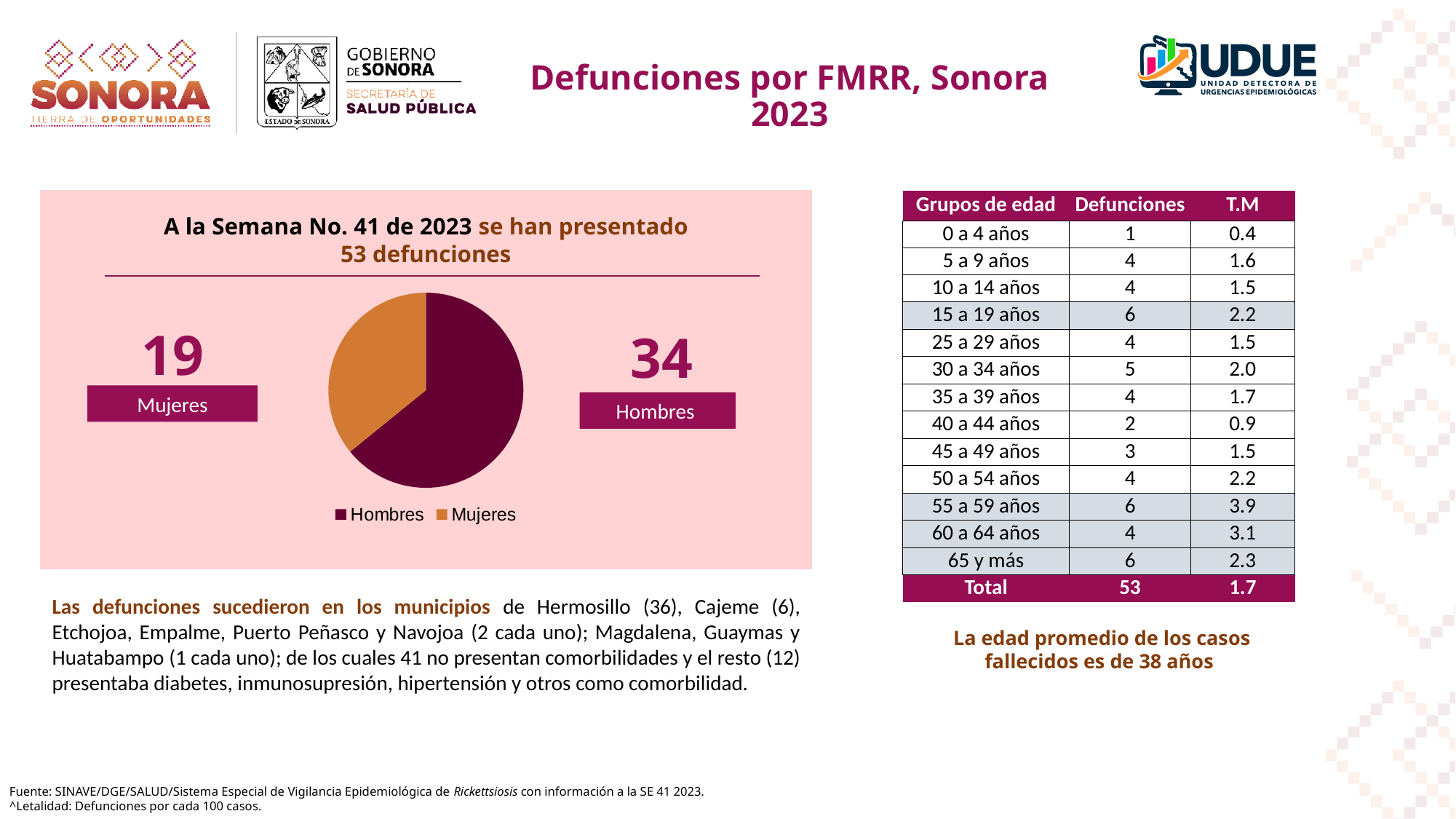
Which category has the smaller slice in the pie chart? Mujeres How many deaths (defunciones) are shown for Mujeres in the pie chart? 19 How many slices does the pie chart have? 2 What is the difference between the number of deaths for Hombres and for Mujeres? 15 Which colour represents Mujeres in the pie chart? orange Which category has the larger slice in the pie chart? Hombres What are the two legend entries of the pie chart? Hombres and Mujeres How many entries does the pie chart legend list? 2 Are there more deaths among Hombres or among Mujeres? Hombres What kind of chart is shown on the slide? pie chart How many deaths (defunciones) are shown for Hombres in the pie chart? 34 What is the total number of deaths represented by the pie chart (Hombres plus Mujeres)? 53